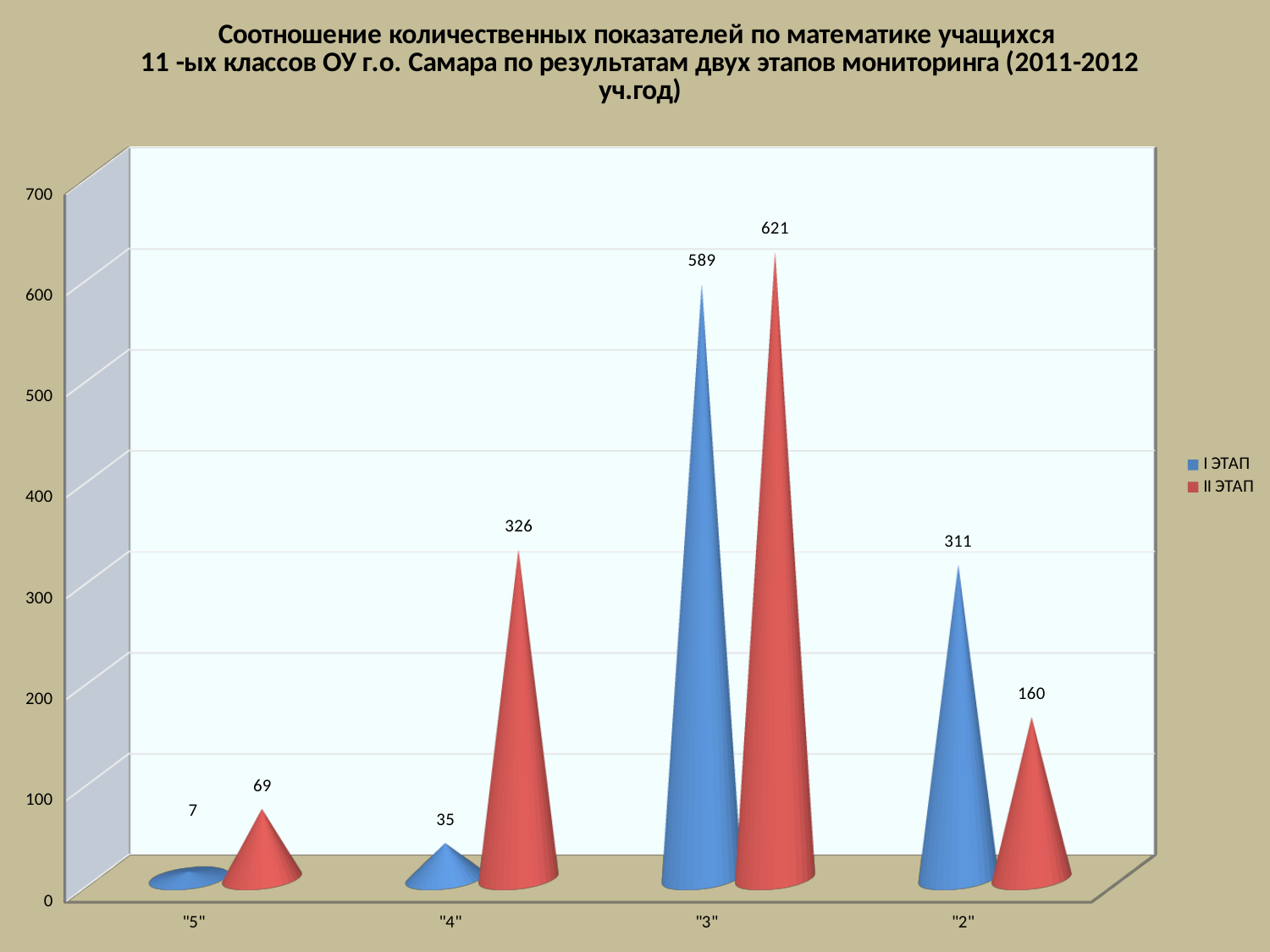
What is the difference between I ЭТАП and II ЭТАП in category "2"? 151 What is the value for I ЭТАП in category "2"? 311 What is the value for II ЭТАП in category "5"? 69 What is the value for II ЭТАП in category "4"? 326 How many categories are shown on the x axis? 4 What is the value for I ЭТАП in category "3"? 589 Which category has the lowest value for I ЭТАП? "5" Which is larger in category "4": I ЭТАП or II ЭТАП? II ЭТАП Which category has the highest value for II ЭТАП? "3" What kind of chart is shown on the slide? Bar chart What is the difference between II ЭТАП and I ЭТАП in category "3"? 32 How many series does the legend list? 2